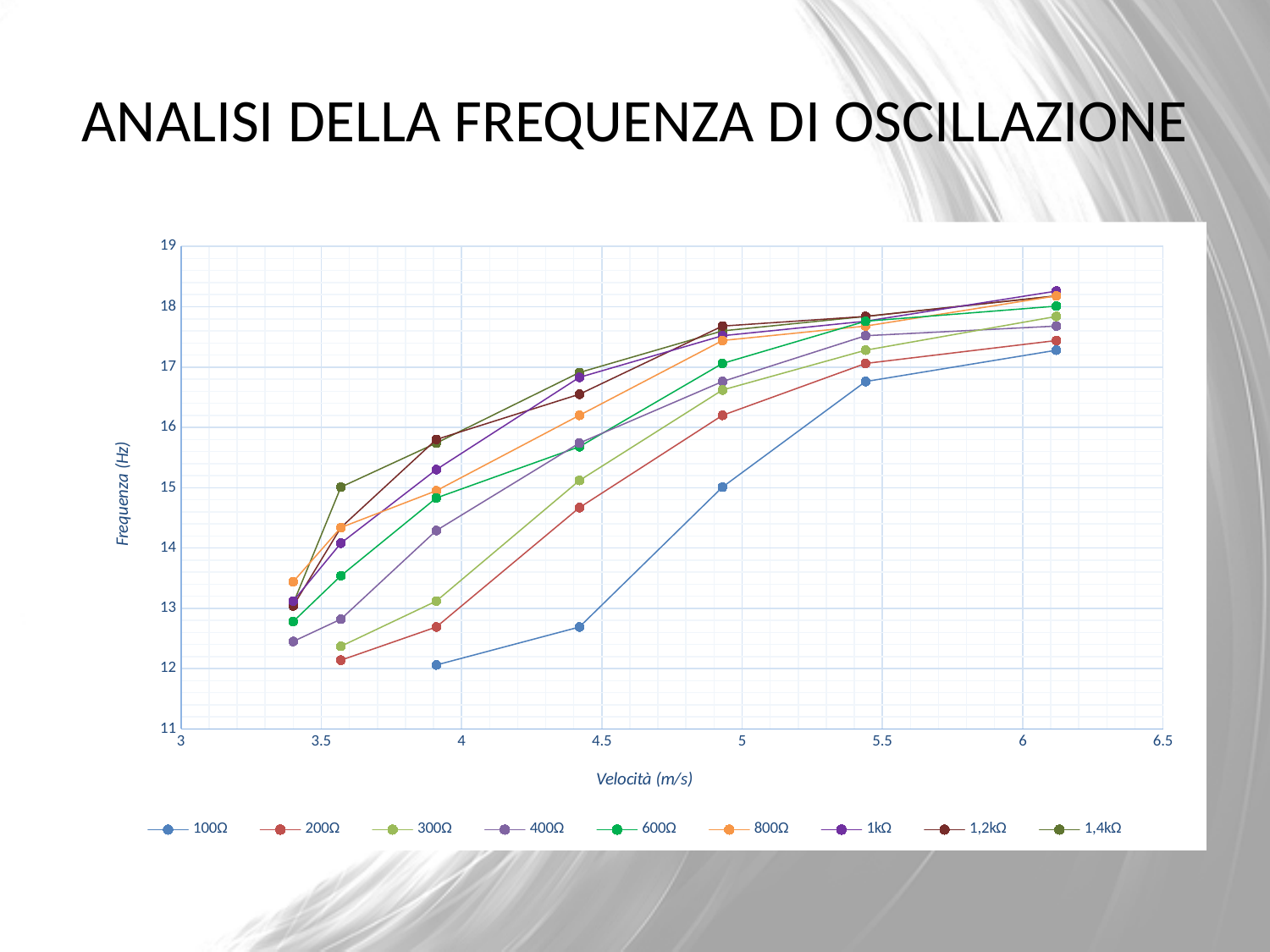
Is the value of the 400Ω series at a velocity of about 3.9 m/s greater or less than 14? greater Is the first (leftmost) value of the 200Ω series greater or less than 13? less At a velocity of about 4.9 m/s, which series has the larger value, 100Ω or 200Ω? 200Ω What is the title of the x axis? Velocità (m/s) What is the title of the y axis? Frequenza (Hz) How many series does the legend list? 9 Is the first (leftmost) value of the 100Ω series greater or less than 13? less Do the frequency values rise or fall as velocity increases along the x axis? rise At a velocity of about 3.9 m/s, which series has the lowest frequency? 100Ω What kind of chart is shown on the slide? line chart How many data points does the 100Ω series have? 5